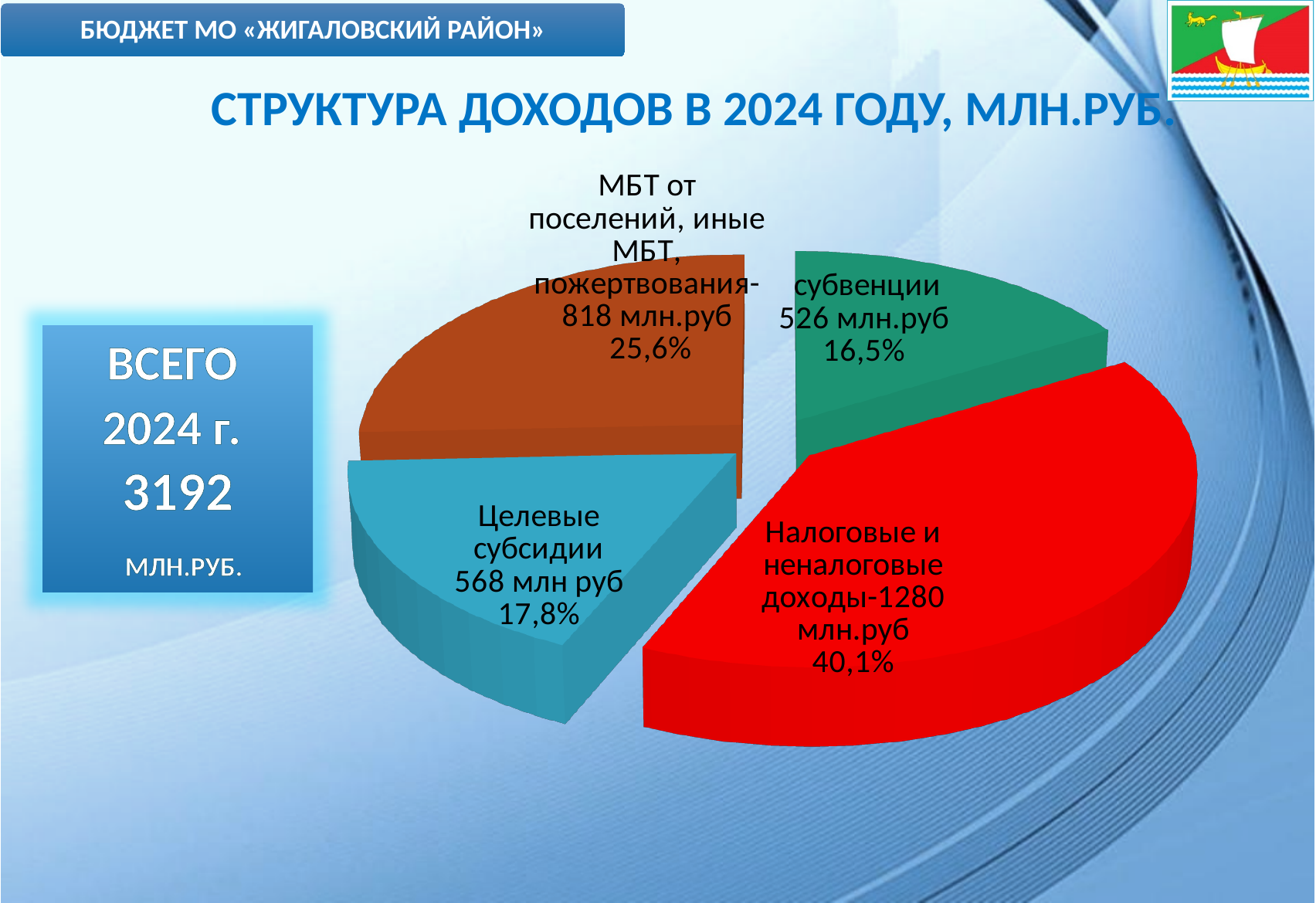
What is the title of the chart? СТРУКТУРА ДОХОДОВ В 2024 ГОДУ, МЛН.РУБ. Which is larger: «Целевые субсидии» or «МБТ от поселений, иные МБТ, пожертвования»? МБТ от поселений, иные МБТ, пожертвования What share of the pie is «МБТ от поселений, иные МБТ, пожертвования»? 25,6% How many slices does the pie chart have? 4 What is the difference in млн.руб between «Налоговые и неналоговые доходы» and «субвенции»? 754 What share of the pie do «Целевые субсидии» make up? 17,8% What is the value for «субвенции»? 526 млн.руб Which category has the largest slice of the pie? Налоговые и неналоговые доходы What kind of chart is shown on the slide? Pie chart Which category has the smallest slice of the pie? субвенции What is the total of all slices in млн.руб, as shown on the slide? 3192 What is the value for «Налоговые и неналоговые доходы»? 1280 млн.руб